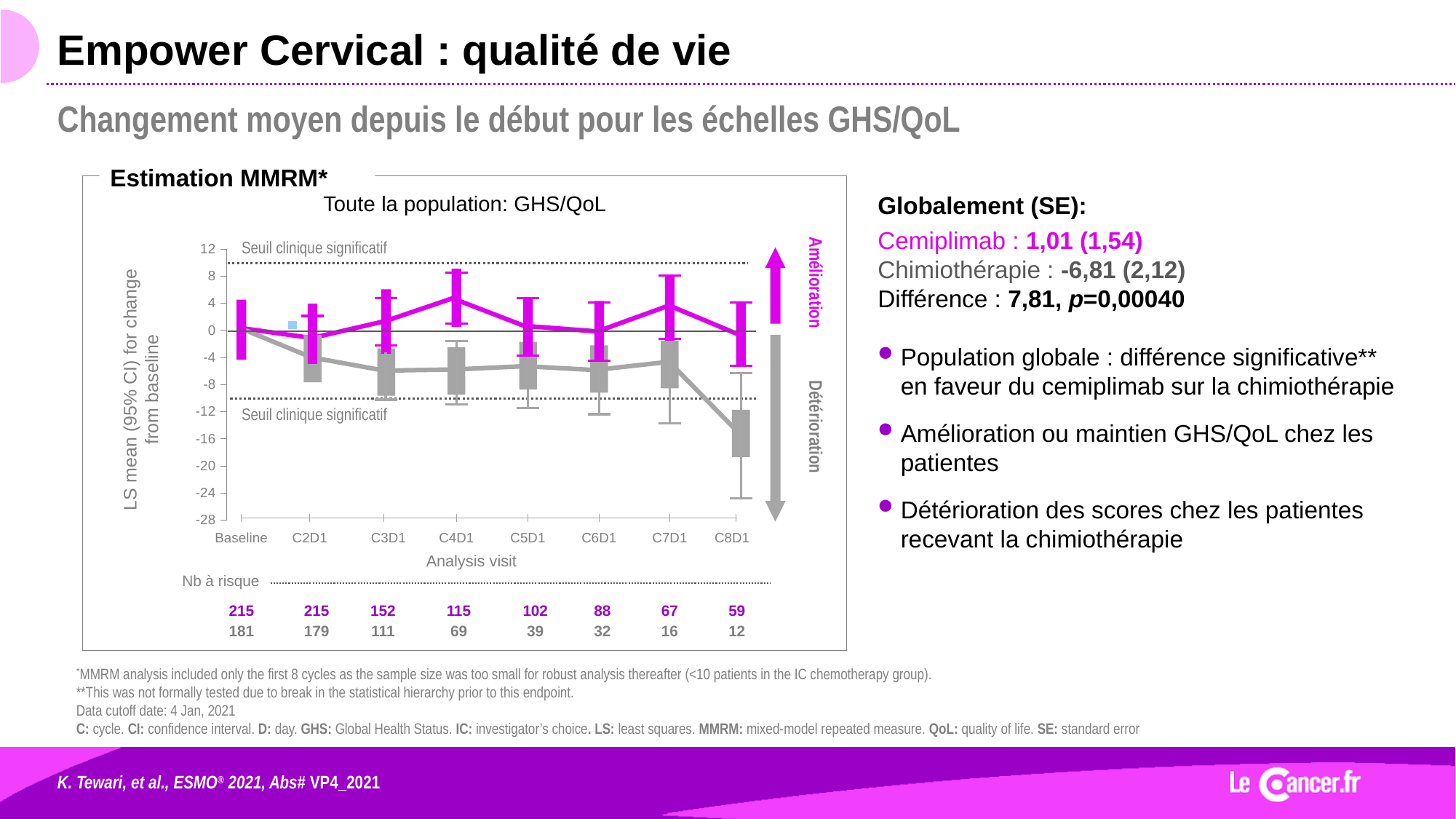
In the chart, is the value of the magenta cemiplimab line at C4D1 greater or less than 0? greater How many analysis visits are shown along the x axis of the chart? 8 What kind of chart is shown under the title "Toute la population: GHS/QoL"? line chart In the chart, is the value of the grey chemotherapy line at C8D1 greater or less than -12? less What is the label of the x axis of the chart? Analysis visit What is the label of the y axis of the chart? LS mean (95% CI) for change from baseline In the "Nb à risque" row, what is the difference between the cemiplimab and chemotherapy numbers at risk at Baseline? 34 In the "Nb à risque" row below the chart, what is the number at risk for the chemotherapy (grey) group at C5D1? 39 Does the grey chemotherapy line rise or fall overall from Baseline to C8D1? fall In the chart, is the value of the grey chemotherapy line at C3D1 greater or less than -4? less At C8D1, which line is higher in the chart: the magenta cemiplimab line or the grey chemotherapy line? magenta cemiplimab line In the "Nb à risque" row below the chart, what is the number at risk for the cemiplimab (magenta) group at C8D1? 59